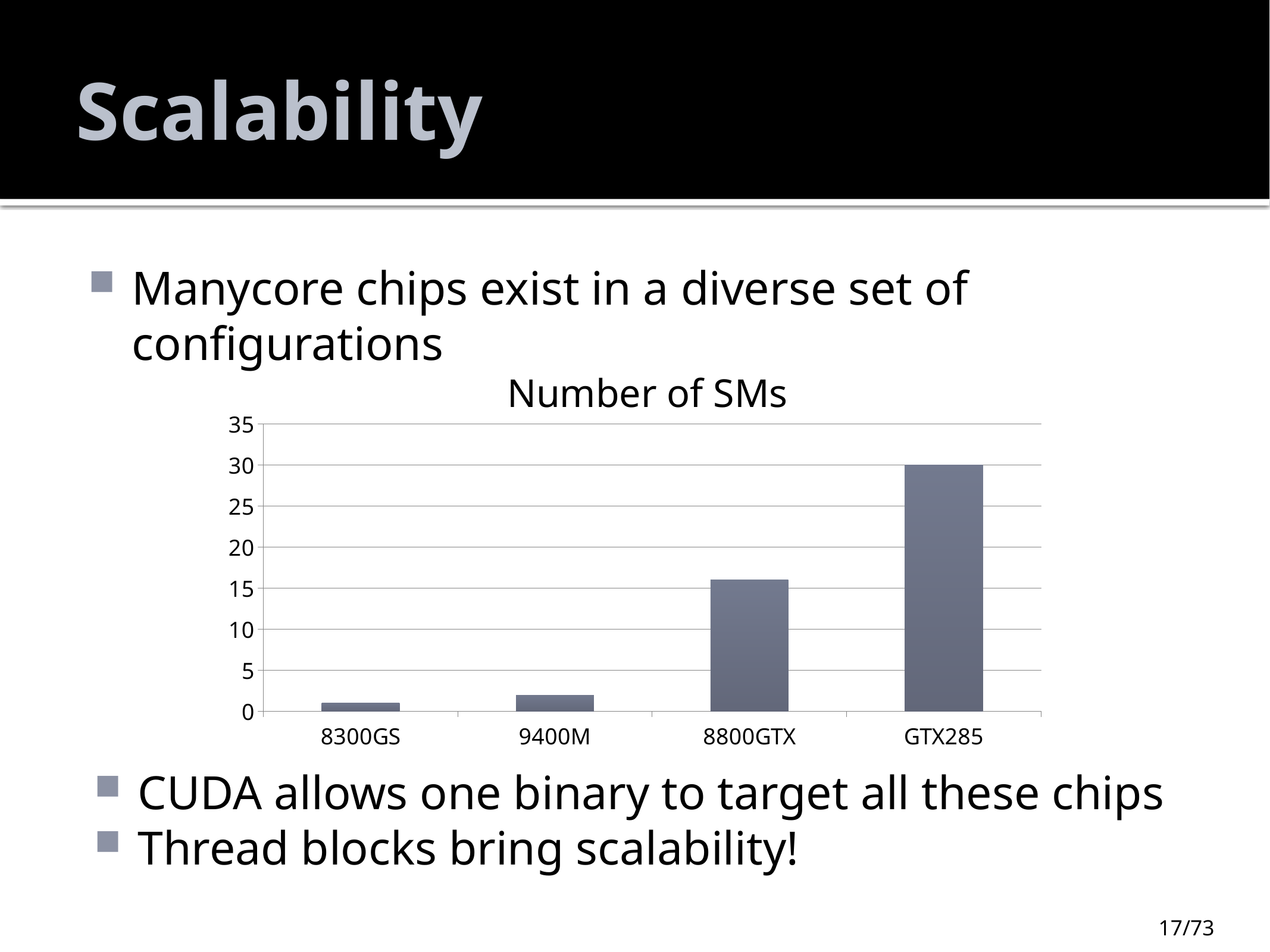
How many categories are shown on the x axis of the "Number of SMs" chart? 4 Is the value for 8800GTX greater or less than 20? less Which is larger in the "Number of SMs" chart, 8800GTX or 9400M? 8800GTX Which category has the highest value in the "Number of SMs" chart? GTX285 Do the values rise or fall from left to right along the x axis of the "Number of SMs" chart? rise Which category has the lowest value in the "Number of SMs" chart? 8300GS What is the title of the chart on the slide? Number of SMs What is the value for GTX285 in the "Number of SMs" chart? 30 Is the value for 9400M greater or less than 5? less Is the value for 8800GTX greater or less than 15? greater What kind of chart is shown under the title "Number of SMs"? bar chart